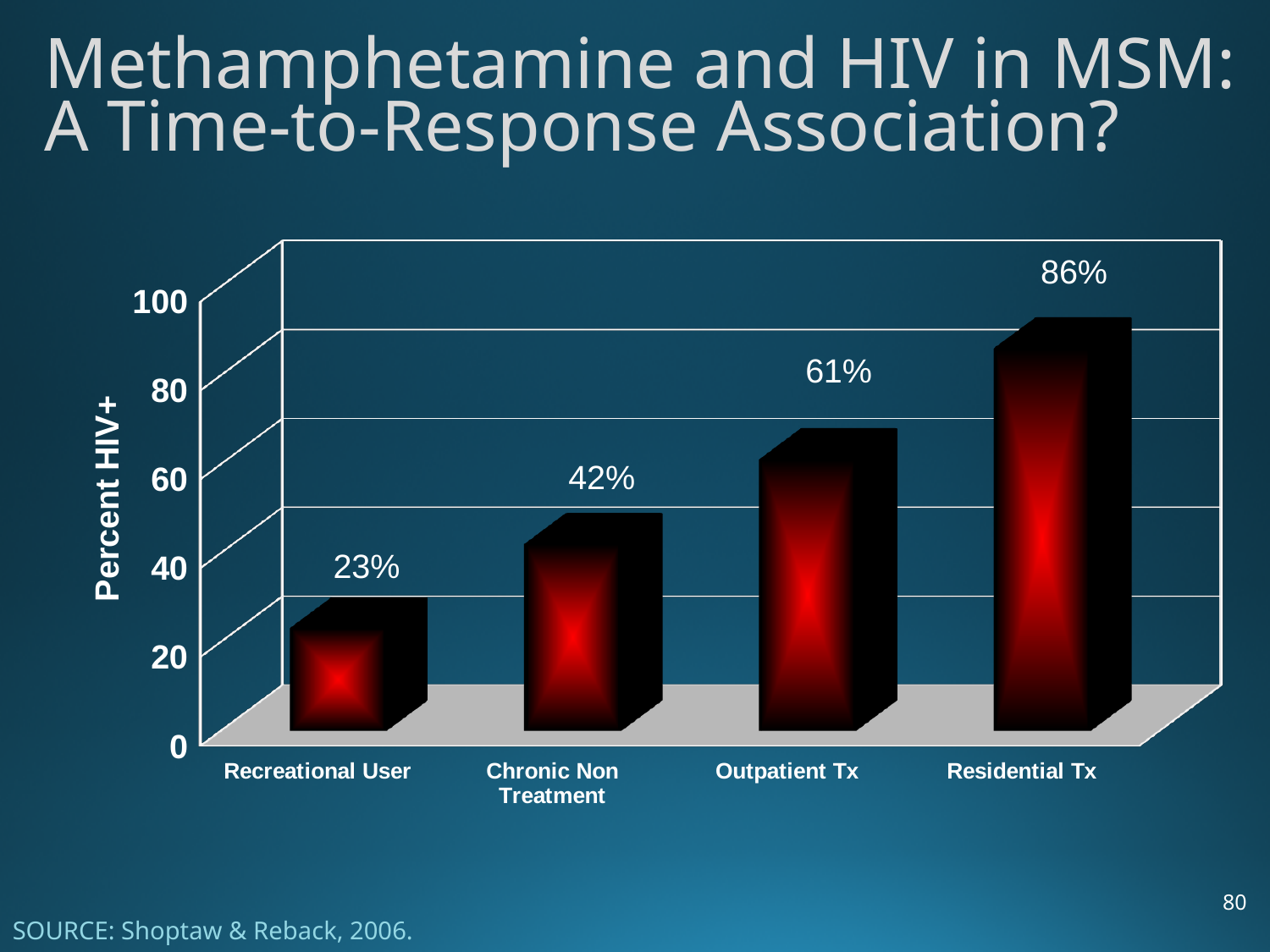
What is the percent HIV+ for Recreational User? 23% What is the difference in percent HIV+ between Outpatient Tx and Chronic Non Treatment? 19% How many categories are shown on the x axis? 4 What is the percent HIV+ for Outpatient Tx? 61% What is the percent HIV+ for Chronic Non Treatment? 42% What is the percent HIV+ for Residential Tx? 86% Do the values rise or fall from left to right along the x axis? Rise What kind of chart is shown on the slide? Bar chart Which category has the lowest percent HIV+? Recreational User What is the difference in percent HIV+ between Residential Tx and Recreational User? 63% Which has a higher percent HIV+, Chronic Non Treatment or Outpatient Tx? Outpatient Tx Which category has the highest percent HIV+? Residential Tx